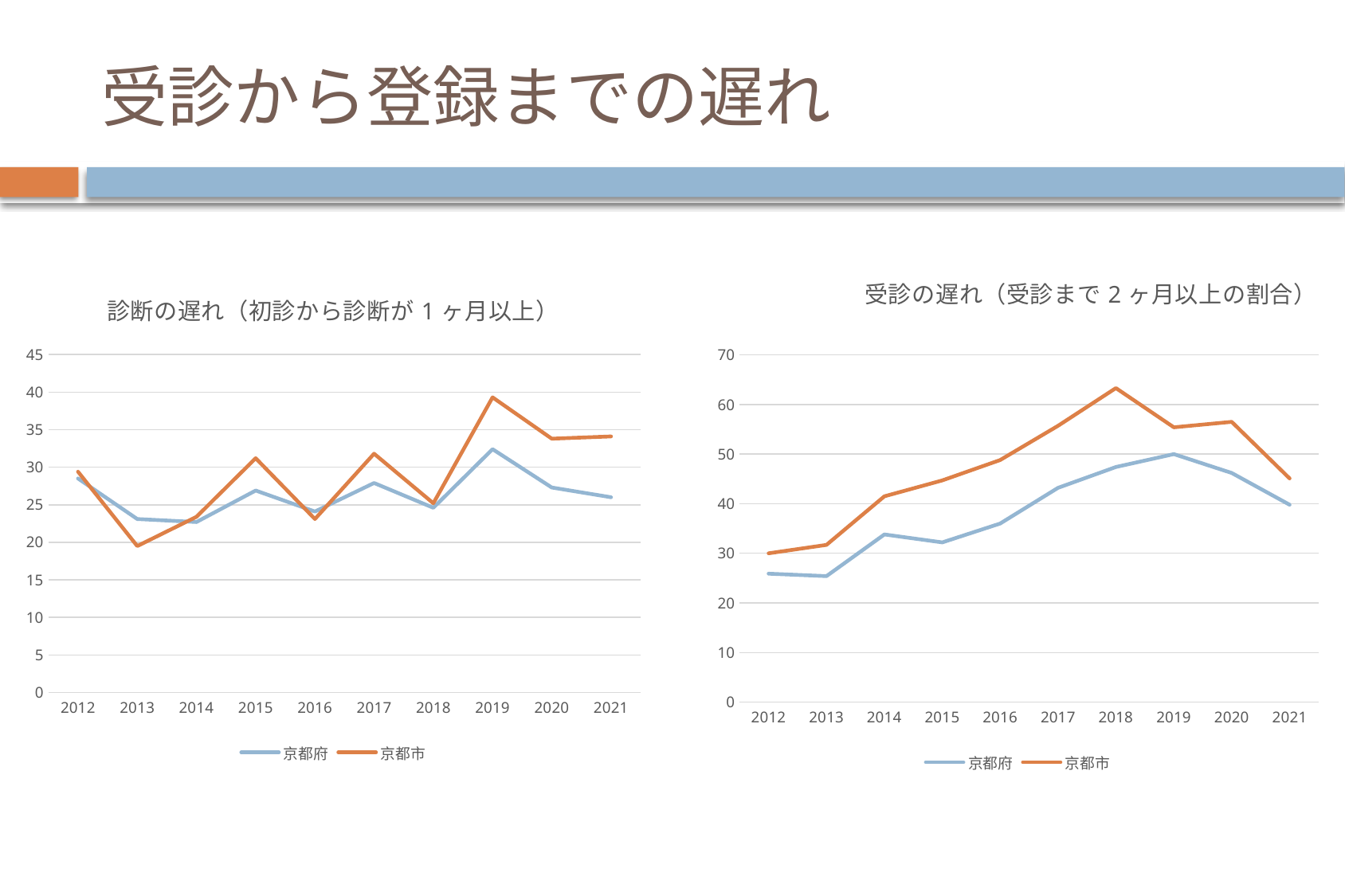
In the left chart titled 診断の遅れ（初診から診断が１ヶ月以上）, is the value for 京都市 in 2019 greater or less than 35? greater In the right chart titled 受診の遅れ（受診まで２ヶ月以上の割合）, in which year does 京都市 reach its highest value? 2018 How many series does the legend of the right chart titled 受診の遅れ（受診まで２ヶ月以上の割合） list? 2 In the right chart titled 受診の遅れ（受診まで２ヶ月以上の割合）, in which year does 京都府 reach its highest value? 2019 In the right chart titled 受診の遅れ（受診まで２ヶ月以上の割合）, does the 京都市 line rise or fall from 2012 to 2018? rise In the left chart titled 診断の遅れ（初診から診断が１ヶ月以上）, in which year does 京都市 reach its highest value? 2019 How many years are plotted along the x axis of the left chart titled 診断の遅れ（初診から診断が１ヶ月以上）? 10 In the right chart titled 受診の遅れ（受診まで２ヶ月以上の割合）, is the value for 京都市 in 2018 greater or less than 60? greater What kind of chart is the left chart titled 診断の遅れ（初診から診断が１ヶ月以上）? line chart In the left chart titled 診断の遅れ（初診から診断が１ヶ月以上）, in which year does 京都市 reach its lowest value? 2013 In the right chart titled 受診の遅れ（受診まで２ヶ月以上の割合）, which series has the larger value in 2018, 京都府 or 京都市? 京都市 In the left chart titled 診断の遅れ（初診から診断が１ヶ月以上）, is the value for 京都府 in 2019 greater or less than 30? greater